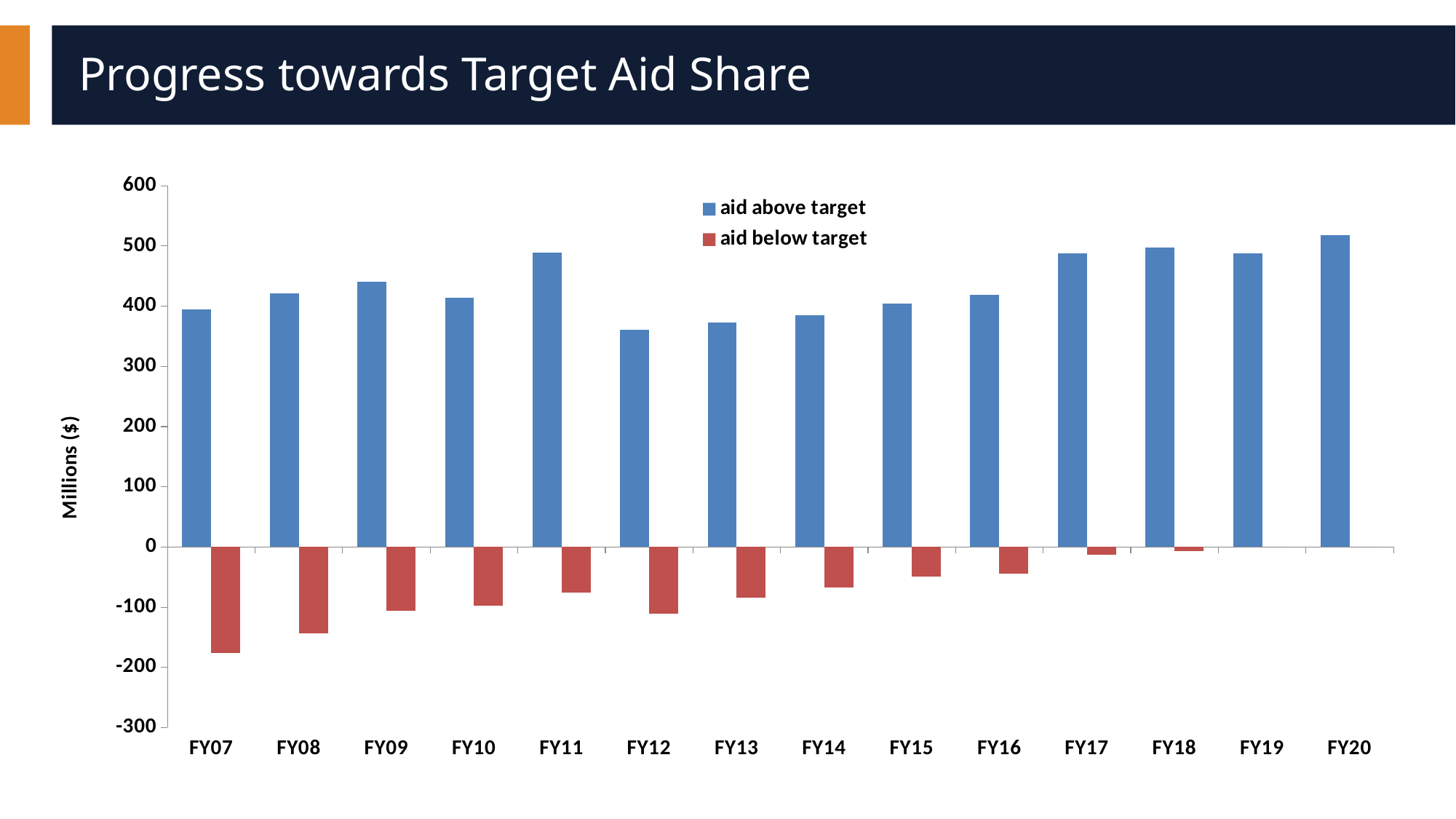
How many series does the legend list? 2 Which fiscal year has the aid below target bar that extends furthest below zero? FY07 What kind of chart is shown on the slide? bar chart Which fiscal year has the lowest value for aid above target? FY12 How many fiscal years are shown on the x axis? 14 Is the value for aid below target in FY15 greater or less than -100? greater Which fiscal year has the highest value for aid above target? FY20 Is the value for aid above target in FY11 greater or less than 400? greater Which is larger, the aid above target value for FY11 or for FY12? FY11 What is the label on the vertical axis? Millions ($) Is the value for aid below target in FY07 greater or less than -100? less